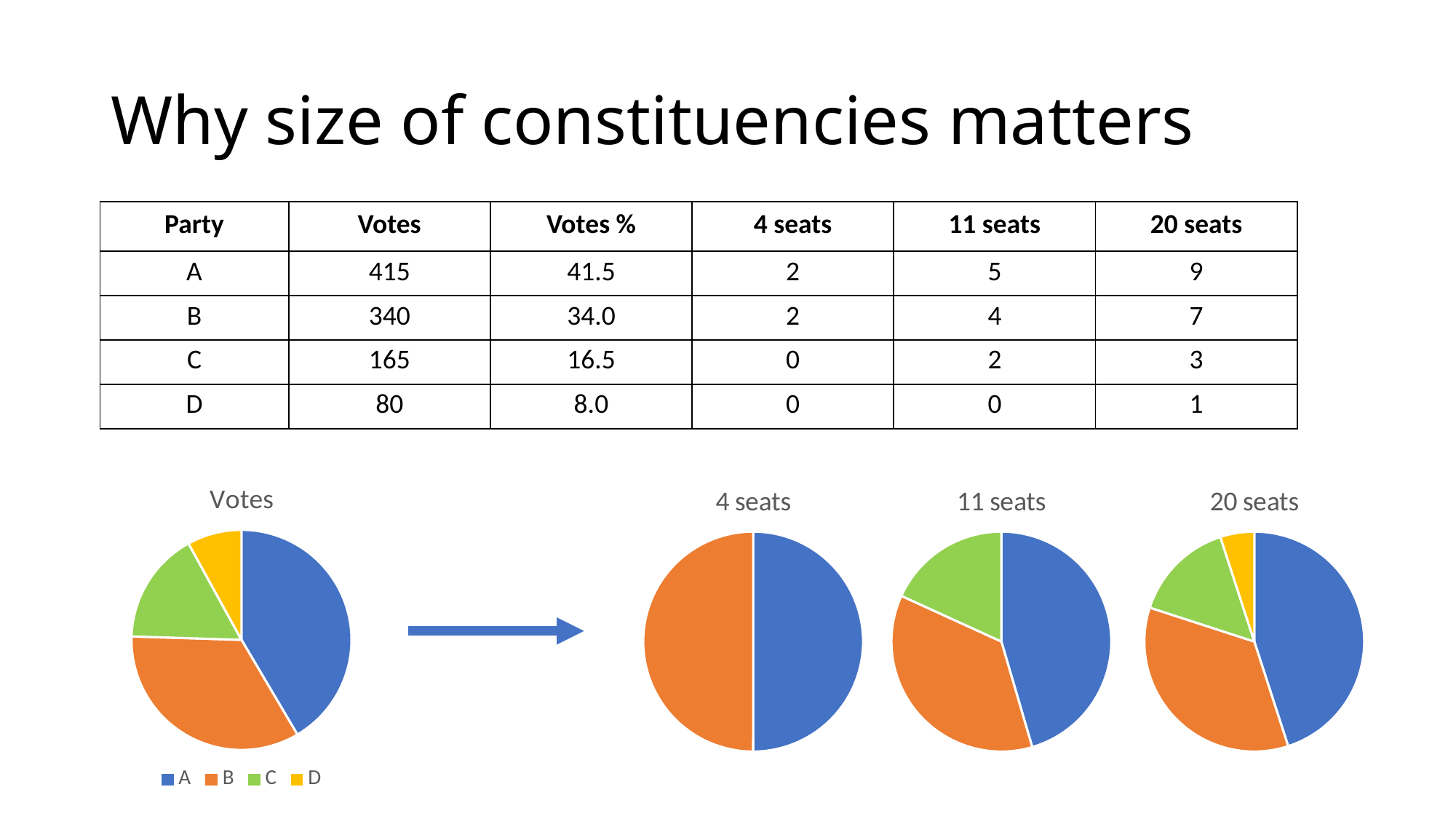
In the "11 seats" pie chart, which slice is larger, B or C? B In the "20 seats" pie chart, which party has the smallest slice? D How many pie charts are shown on the slide? 4 In the "Votes" pie chart, which party has the smallest slice? D How many slices does the "4 seats" pie chart have? 2 In the "11 seats" pie chart, which party has the largest slice? A How many slices does the "11 seats" pie chart have? 3 How many entries does the legend under the "Votes" pie chart list? 4 How many slices does the "Votes" pie chart have? 4 In the "Votes" pie chart, what is the number of votes for party A? 415 In the "Votes" pie chart, which party has the largest slice? A What kind of chart is the "Votes" chart? Pie chart